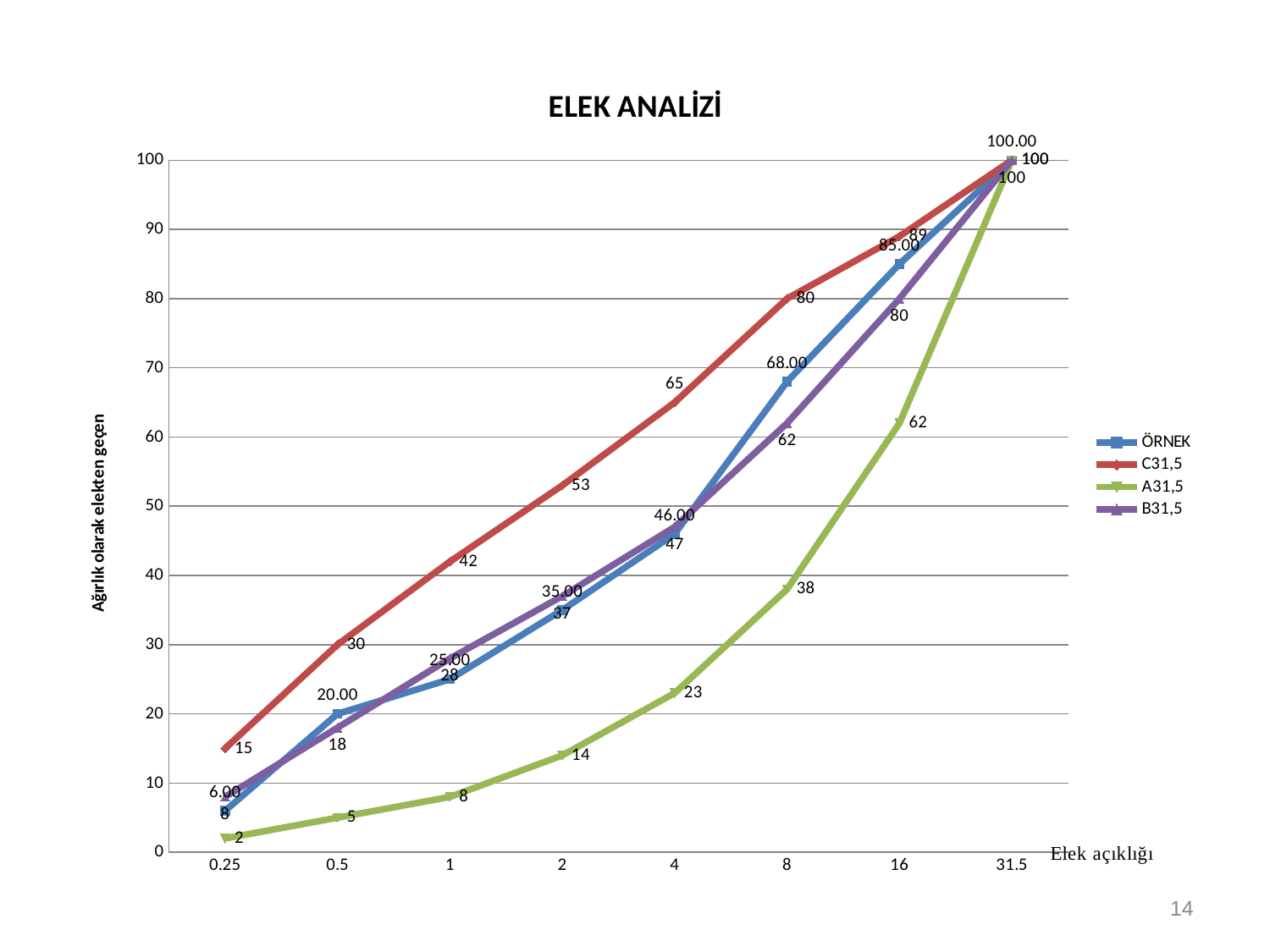
What is the difference between the C31,5 and A31,5 values at sieve opening 8? 42 What type of chart is shown on the slide? line chart Which series has the lowest value at sieve opening 4? A31,5 How many sieve opening values are plotted along the x axis? 8 Which series has the highest value at sieve opening 1? C31,5 What is the value of the B31,5 series at sieve opening 0.5? 18 At sieve opening 16, which is larger: the ÖRNEK value or the B31,5 value? ÖRNEK What is the value of the C31,5 series at sieve opening 2? 53 What is the value of the ÖRNEK series at sieve opening 8? 68.00 Do the values of the A31,5 series rise or fall as the sieve opening increases? rise What is the value of the A31,5 series at sieve opening 16? 62 How many series does the legend list? 4